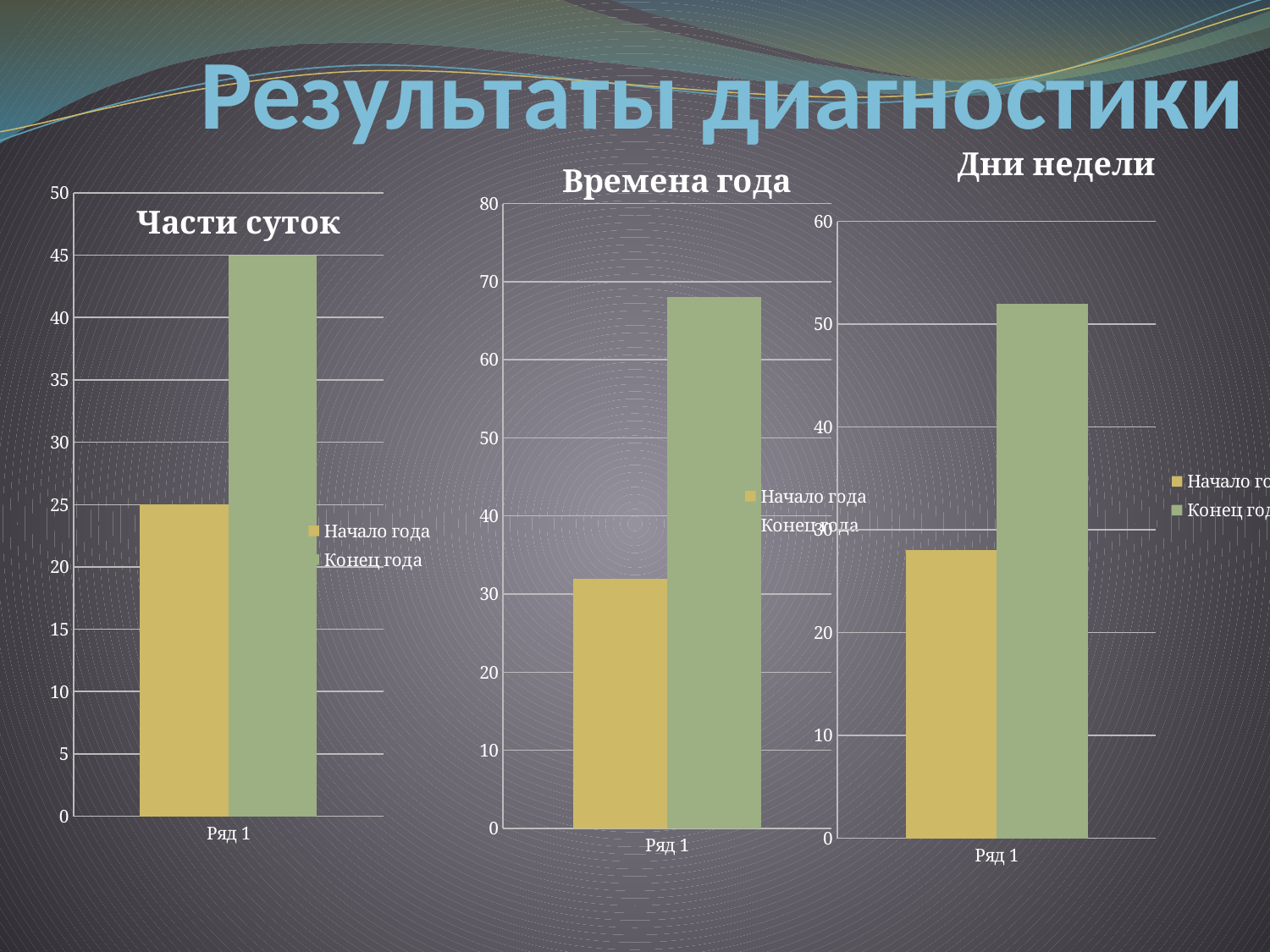
In the 'Дни недели' chart, which series has the lowest value? Начало года What kind of chart is the 'Части суток' chart? bar chart In the 'Части суток' chart, what is the value for Начало года? 25 How many series does the legend of the 'Времена года' chart list? 2 In the 'Части суток' chart, what is the value for Конец года? 45 In the 'Времена года' chart, which series has the higher value, Начало года or Конец года? Конец года In the 'Дни недели' chart, is the value for Начало года greater or less than 30? less In the 'Времена года' chart, is the value for Конец года greater or less than 60? greater What is the title of the middle chart on the slide? Времена года In the 'Времена года' chart, is the value for Начало года greater or less than 40? less In the 'Части суток' chart, what is the difference between Конец года and Начало года? 20